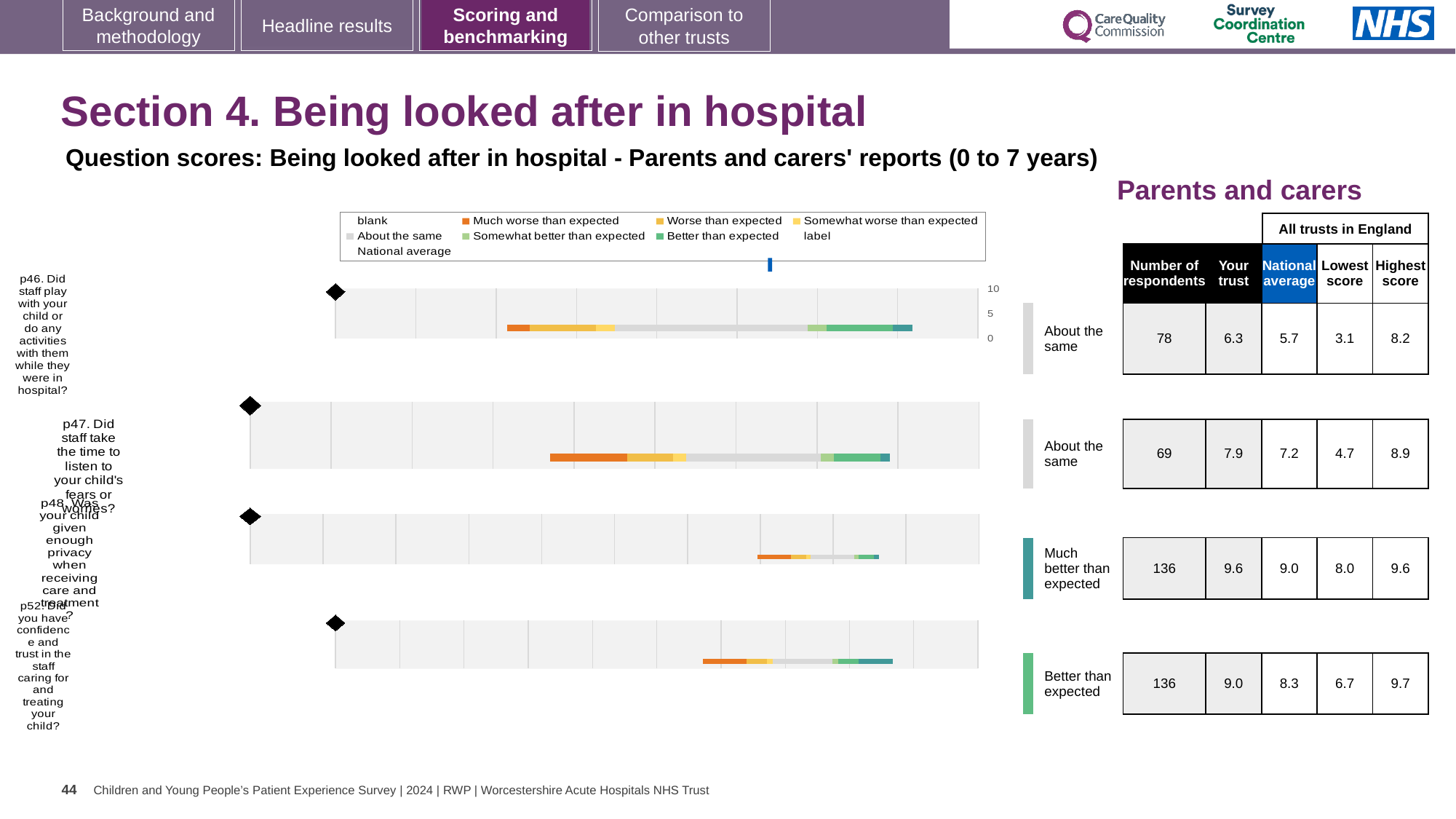
For p47, how much higher is the 'Your trust' score than the national average? 0.7 What is the highest score among all trusts in England for p52 (Did you have confidence and trust in the staff caring for and treating your child?)? 9.7 Which question has the highest 'Your trust' score? p48 What is the 'Your trust' score for p46 (Did staff play with your child or do any activities with them while they were in hospital?)? 6.3 Which has the larger 'Your trust' score, p48 or p52? p48 What benchmark category is shown for p48 (Was your child given enough privacy when receiving care and treatment?)? Much better than expected What is the lowest score among all trusts in England for p46? 3.1 How many respondents answered p48 (Was your child given enough privacy when receiving care and treatment?)? 136 What kind of chart is used to show the question scores on this slide? bar chart Which question has the lowest 'Your trust' score? p46 How many survey questions (p46, p47, p48, p52) are plotted on the slide? 4 What is the national average score for p47 (Did staff take the time to listen to your child's fears or worries?)? 7.2